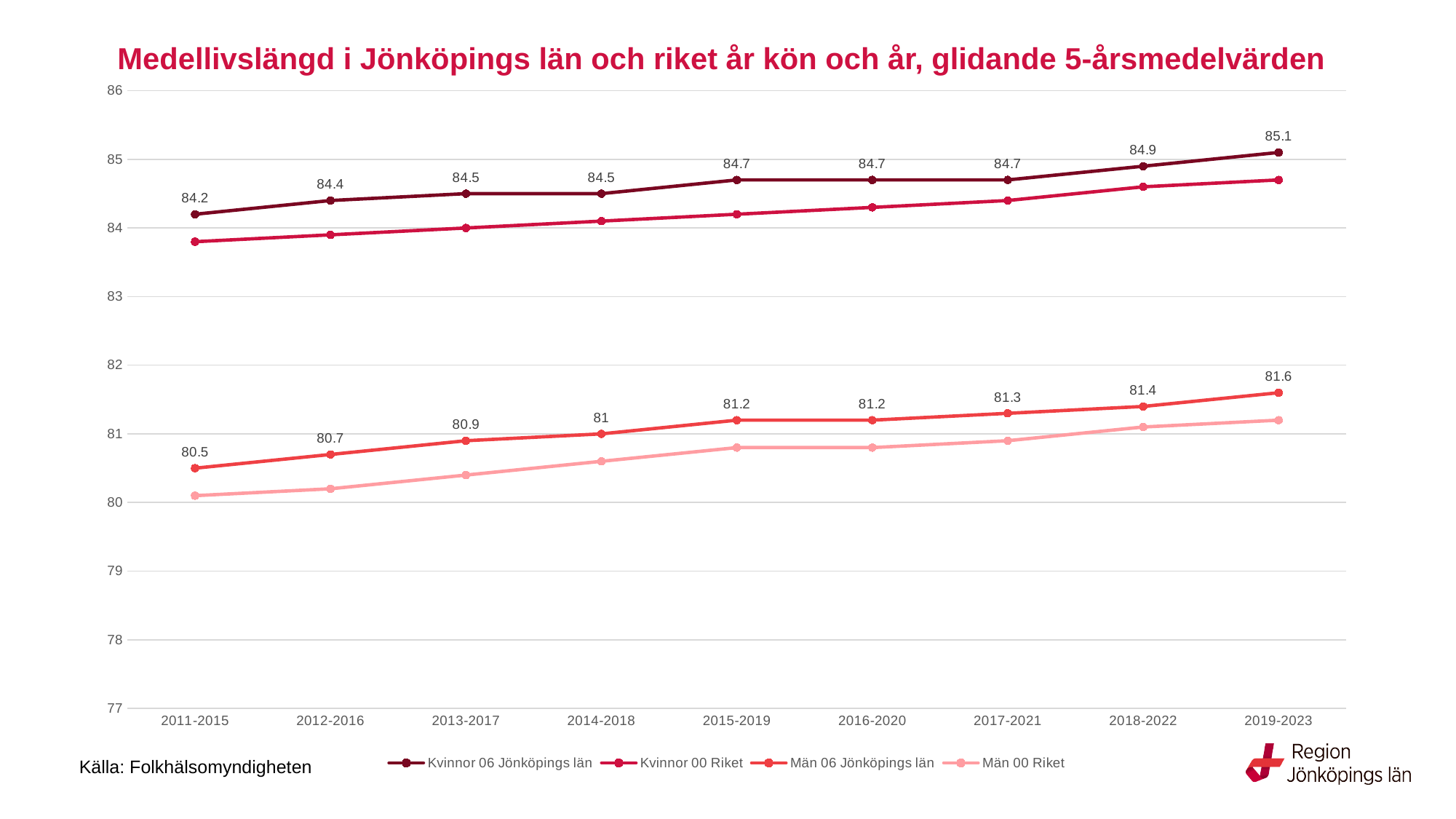
In which period is the value for Kvinnor 06 Jönköpings län lowest? 2011-2015 What kind of chart is shown on the slide? line chart What is the value for Kvinnor 06 Jönköpings län in 2019-2023? 85.1 Is the value for Män 00 Riket in 2011-2015 greater or less than 81? less What is the value for Kvinnor 06 Jönköpings län in 2015-2019? 84.7 How many series does the legend list? 4 What is the value for Män 06 Jönköpings län in 2017-2021? 81.3 What is the difference between the Kvinnor 06 Jönköpings län value in 2019-2023 and in 2011-2015? 0.9 How many periods are shown on the x axis? 9 Which is larger in 2019-2023: Kvinnor 06 Jönköpings län or Män 06 Jönköpings län? Kvinnor 06 Jönköpings län What is the value for Män 06 Jönköpings län in 2011-2015? 80.5 In which period is the value for Män 06 Jönköpings län highest? 2019-2023